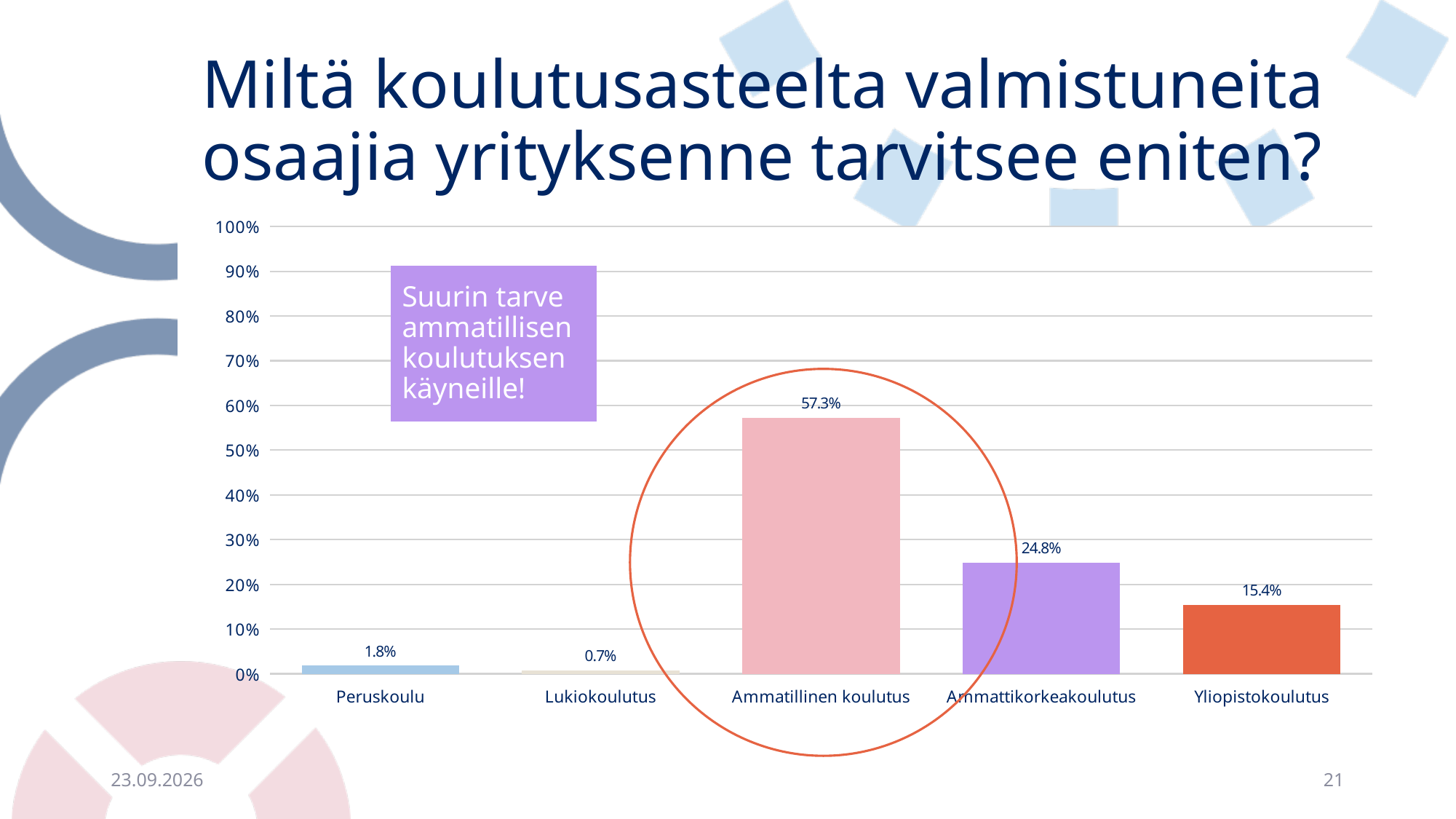
What is the value for Ammatillinen koulutus? 57.3% What is the value for Ammattikorkeakoulutus? 24.8% What is the value for Peruskoulu? 1.8% Which is larger, the value for Ammattikorkeakoulutus or Yliopistokoulutus? Ammattikorkeakoulutus How many categories are shown on the x axis? 5 What is the value for Yliopistokoulutus? 15.4% Is the value for Ammatillinen koulutus greater or less than 50%? greater Which category has the lowest value? Lukiokoulutus Which category has the highest value? Ammatillinen koulutus What is the value for Lukiokoulutus? 0.7% What is the difference between the values for Ammatillinen koulutus and Ammattikorkeakoulutus? 32.5% What kind of chart is shown on the slide? bar chart